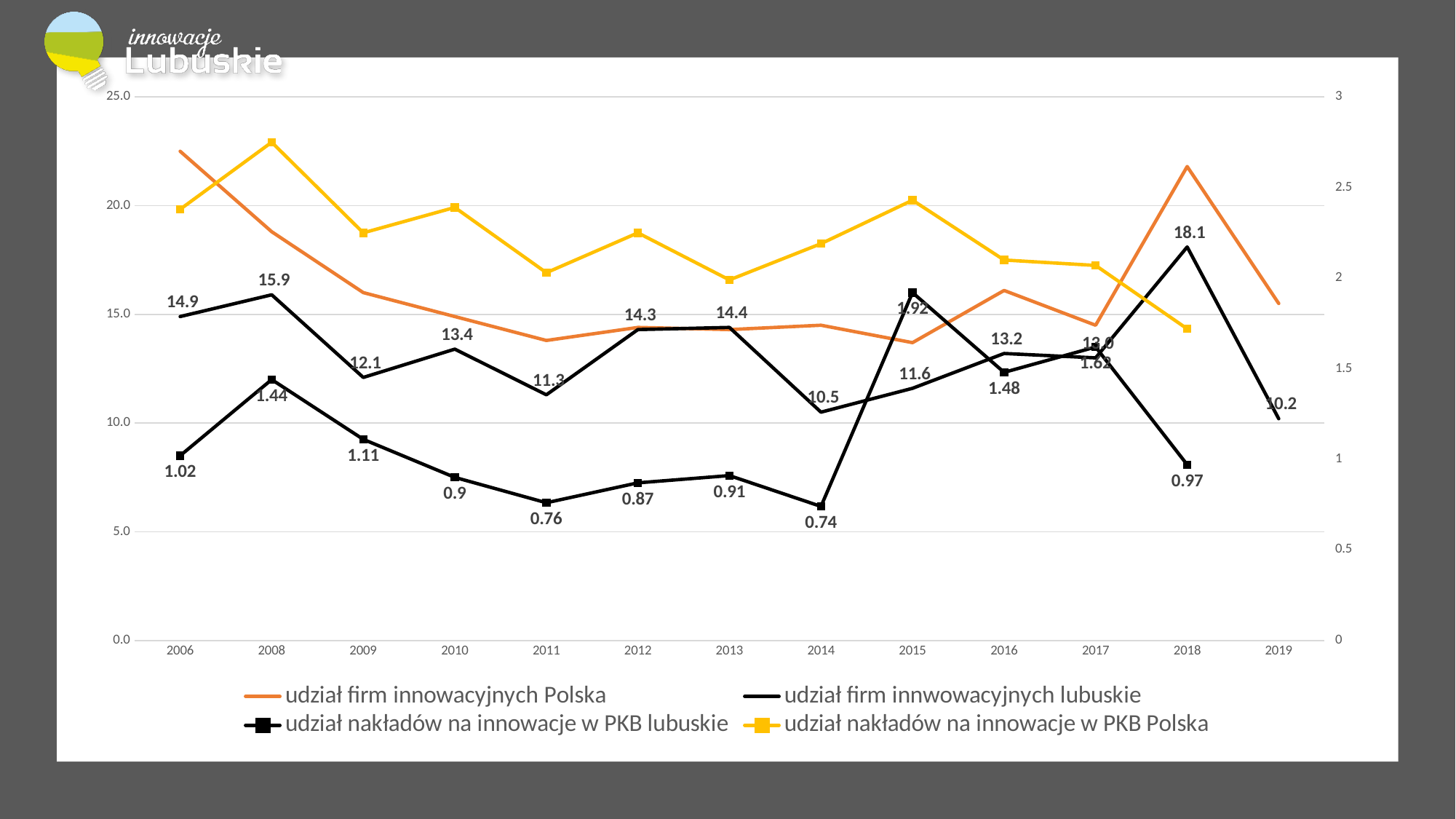
How many series does the legend list? 4 In which year is 'udział nakładów na innowacje w PKB lubuskie' lowest? 2014 What is the difference between the 2018 and 2019 values of 'udział firm innwowacyjnych lubuskie'? 7.9 Is the value of 'udział firm innowacyjnych Polska' in 2006 greater or less than 20.0? greater Does 'udział nakładów na innowacje w PKB Polska' rise or fall from 2015 to 2018? fall How many years are shown on the x axis? 13 In which year is 'udział firm innwowacyjnych lubuskie' lowest? 2019 What type of chart is shown on the slide? line chart What is the value of 'udział nakładów na innowacje w PKB lubuskie' in 2015? 1.92 In which year is 'udział nakładów na innowacje w PKB lubuskie' highest? 2015 Which is larger for 'udział firm innwowacyjnych lubuskie': the value in 2008 or the value in 2009? 2008 What is the value of 'udział firm innwowacyjnych lubuskie' in 2018? 18.1